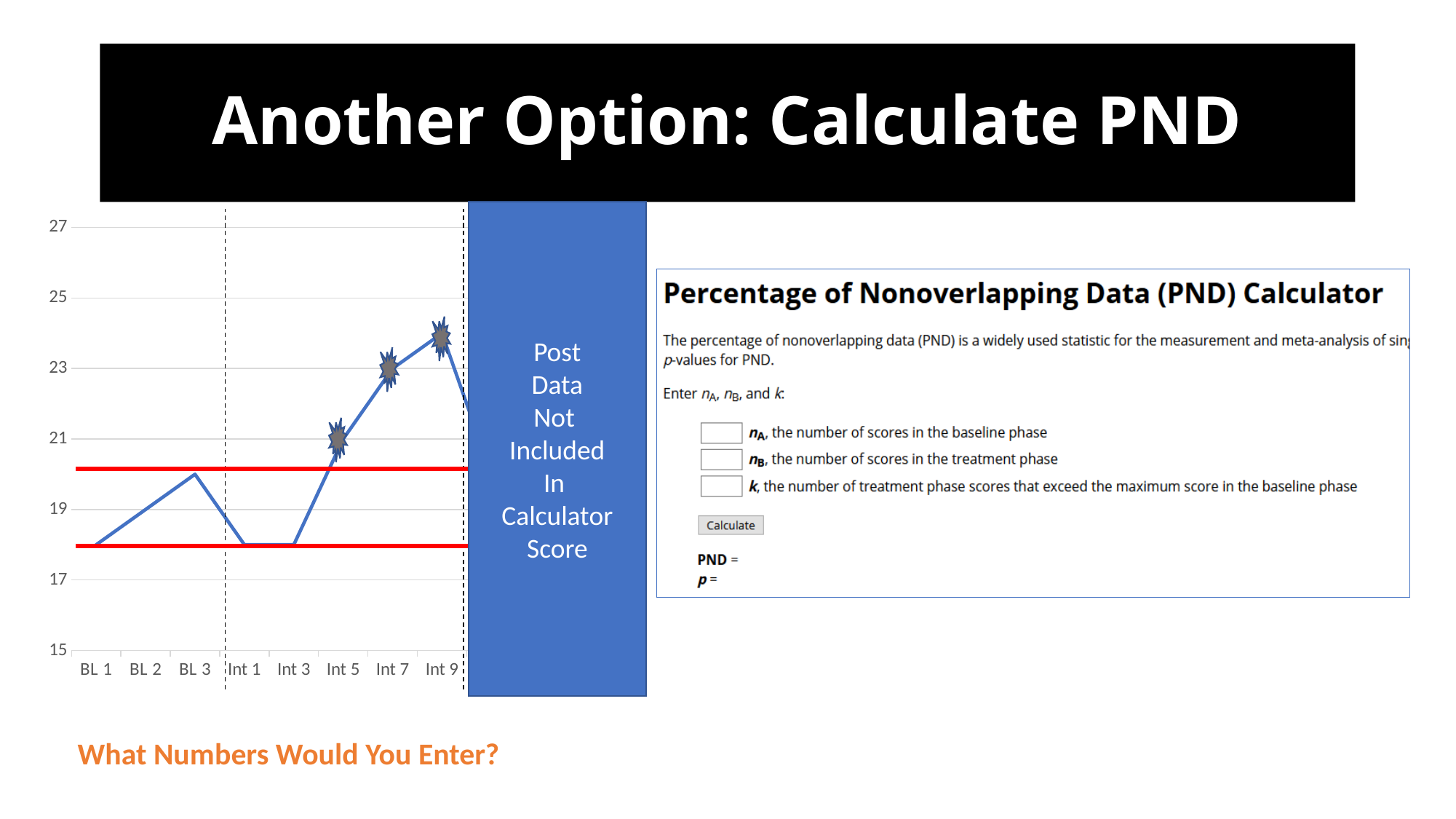
Which of the labelled points on the chart has the highest value? Int 9 Is the value for Int 1 greater or less than 19? less Is the value for Int 7 greater or less than 21? greater Do the values rise or fall from Int 1 to Int 9? rise What colour are the two horizontal lines drawn across the chart? red What kind of chart is shown on the left of the slide? line chart Is the value for Int 5 greater or less than 19? greater Which is larger, the value for Int 7 or the value for BL 3? Int 7 How many category labels are readable on the x axis of the chart? 8